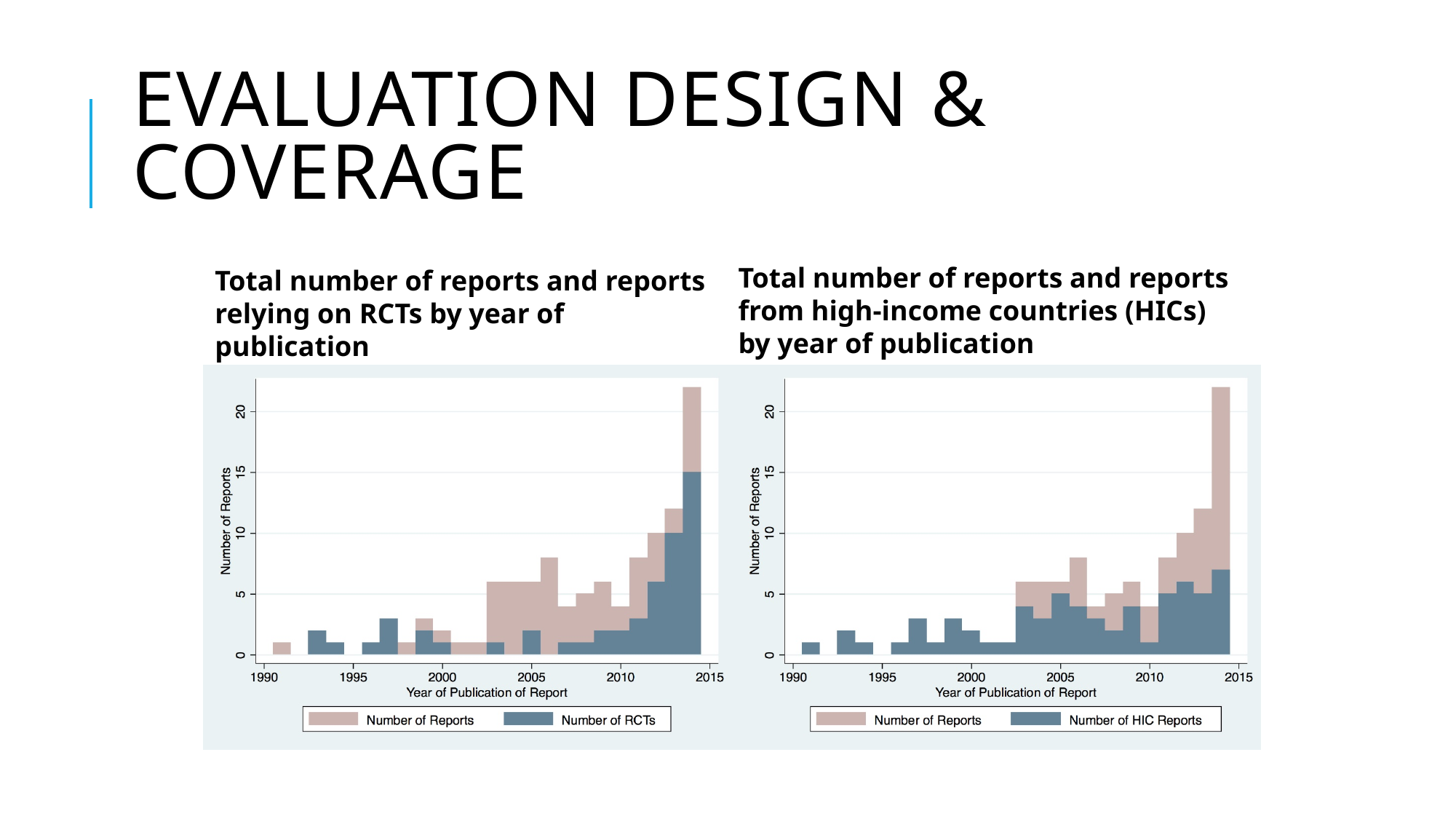
Which is larger: the number of RCTs for 2014 in the left chart or the number of HIC reports for 2014 in the right chart? Number of RCTs for 2014 in the left chart In the left chart, what is the number of RCTs for 2014? 15 In the right chart, do the number of reports generally rise or fall from 2010 to 2014? rise How many series does the legend of the right chart, 'Total number of reports and reports from high-income countries (HICs) by year of publication', list? 2 In the right chart, is the number of HIC reports for 2014 greater or less than 10? less In the right chart, what is the number of HIC reports for 2005? 5 What is the x-axis label of the left chart? Year of Publication of Report In the right chart, is the number of reports for 2014 greater or less than 20? greater In the left chart, what is the number of RCTs for 2013? 10 What kind of chart is the left chart, 'Total number of reports and reports relying on RCTs by year of publication'? bar chart In the left chart, is the number of reports for 2006 greater or less than 5? greater In the left chart, which year has the highest number of reports? 2014